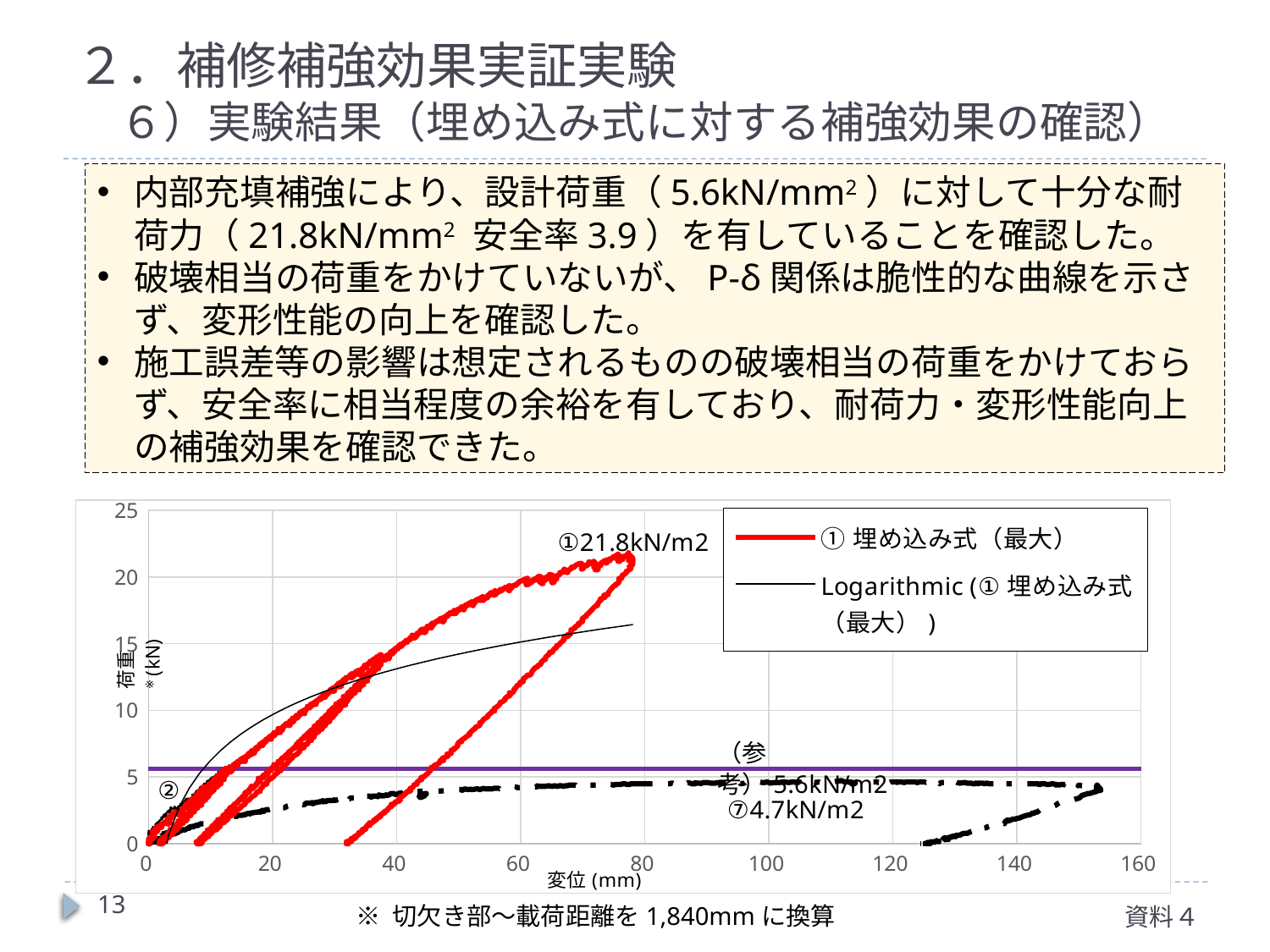
Does the load of series ① rise or fall as displacement increases from 0 to about 80 mm? rise What load value is labelled for series ⑦? 4.7kN/m2 How many series does the chart legend list? 2 What kind of chart is shown on the slide? line chart What is the label of the x axis? 変位 (mm) Is the peak load of series ① greater or less than 20? greater What value is labelled for the reference (参考) horizontal line? 5.6kN/m2 What is the difference between the labelled maximum of series ① (21.8kN/m2) and the reference value (5.6kN/m2)? 16.2kN/m2 What is the maximum load labelled for series ① 埋め込み式（最大）? 21.8kN/m2 What is the difference between the labelled maximum of series ① (21.8kN/m2) and the labelled value of series ⑦ (4.7kN/m2)? 17.1kN/m2 What is the highest tick value shown on the x axis? 160 Which reaches a higher load: series ① or series ⑦? series ①